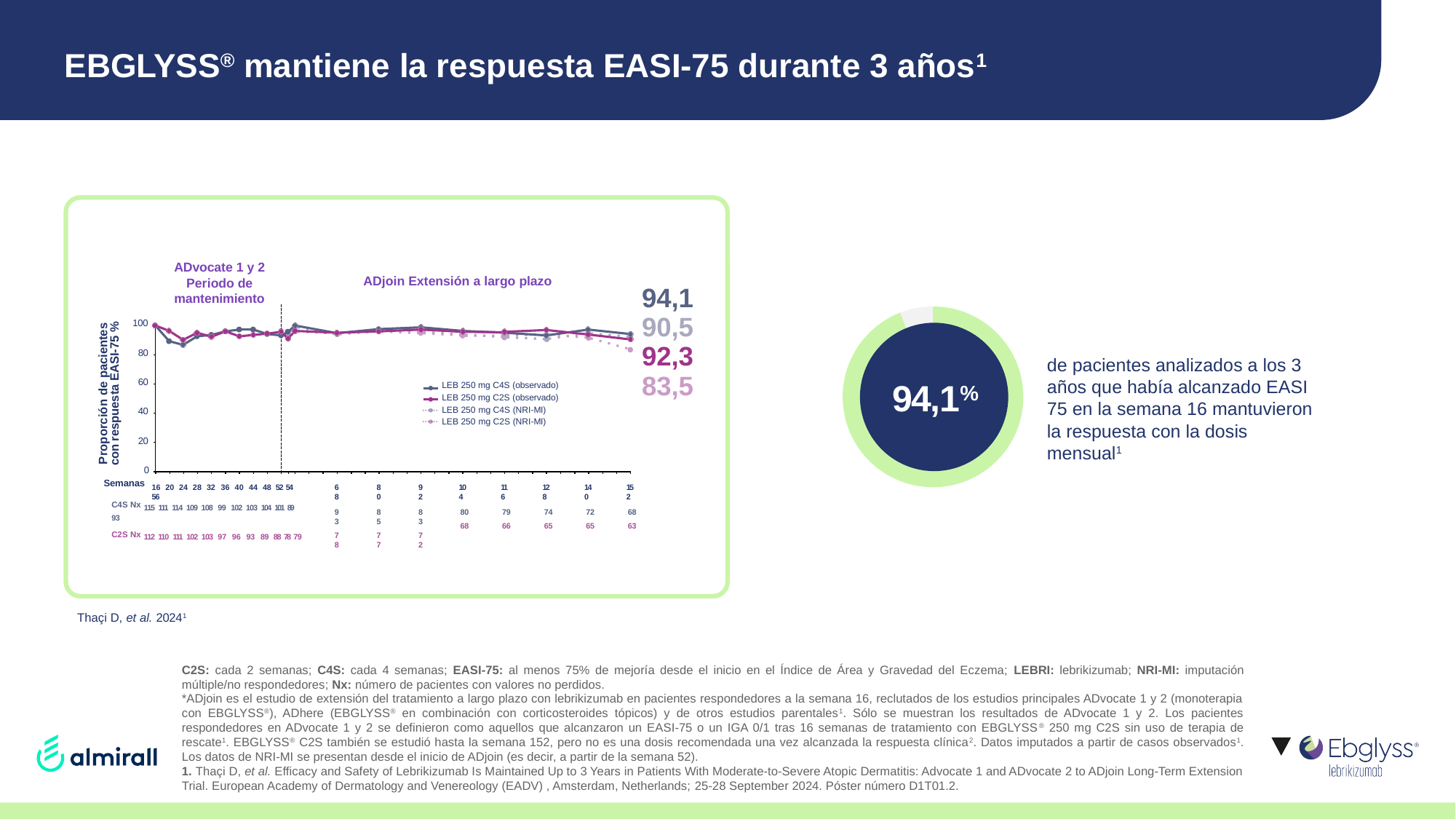
In the line chart on the left, what is the final value shown for LEB 250 mg C2S (NRI-MI)? 83,5 In the line chart on the left, what is the final value shown for LEB 250 mg C2S (observado)? 92,3 In the line chart on the left, is the value for LEB 250 mg C4S (observado) at week 16 greater or less than 80? greater In the line chart on the left, what is the difference between the final values of LEB 250 mg C4S (observado) and LEB 250 mg C2S (NRI-MI)? 10,6 In the line chart on the left, what is the label of the y axis? Proporción de pacientes con respuesta EASI-75 % In the line chart on the left, which final value is larger: LEB 250 mg C4S (NRI-MI) or LEB 250 mg C2S (observado)? LEB 250 mg C2S (observado) In the line chart on the left, what is the final value shown for LEB 250 mg C4S (observado)? 94,1 What value is shown in the centre of the donut chart on the right? 94,1% What kind of chart is the chart on the left of the slide? line chart In the line chart on the left, how many series does the legend list? 4 In the line chart on the left, which series has the lowest final value? LEB 250 mg C2S (NRI-MI) In the line chart on the left, which series has the highest final value? LEB 250 mg C4S (observado)